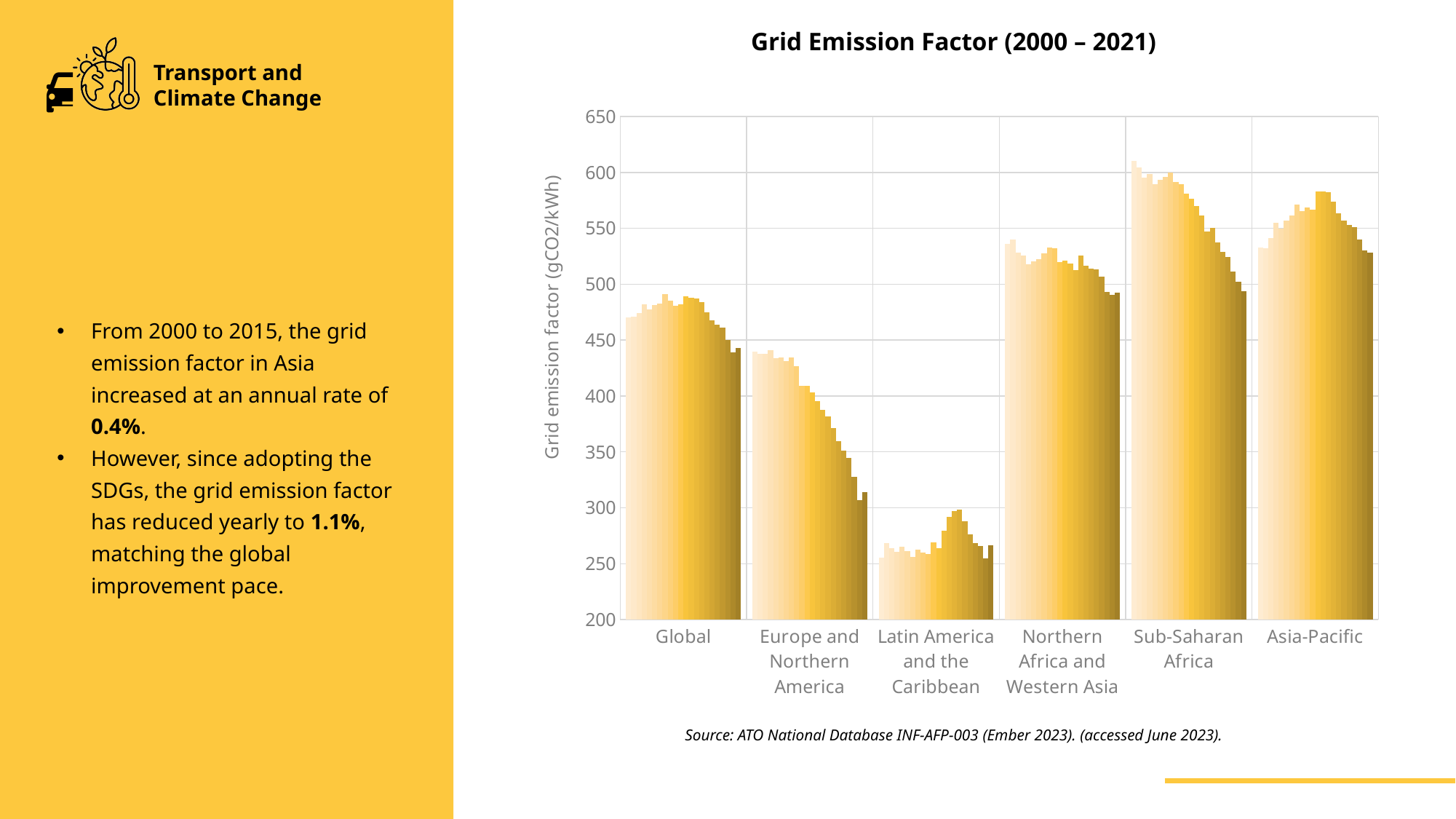
Which region contains the tallest bar in the chart? Sub-Saharan Africa What kind of chart is shown on the slide? bar chart What is the label of the vertical axis of the chart? Grid emission factor (gCO2/kWh) What is the title of the chart? Grid Emission Factor (2000 – 2021) Are the values for Latin America and the Caribbean greater or less than 350? less Are the values for Asia-Pacific greater or less than 500? greater How many regional categories are shown on the x axis of the chart? 6 Which region has the lowest grid emission factor values in the chart? Latin America and the Caribbean Is the last (2021) bar for Europe and Northern America greater or less than 350? less Do the values for Europe and Northern America rise or fall from 2000 to 2021? fall Which region has higher grid emission factor values, Asia-Pacific or Global? Asia-Pacific